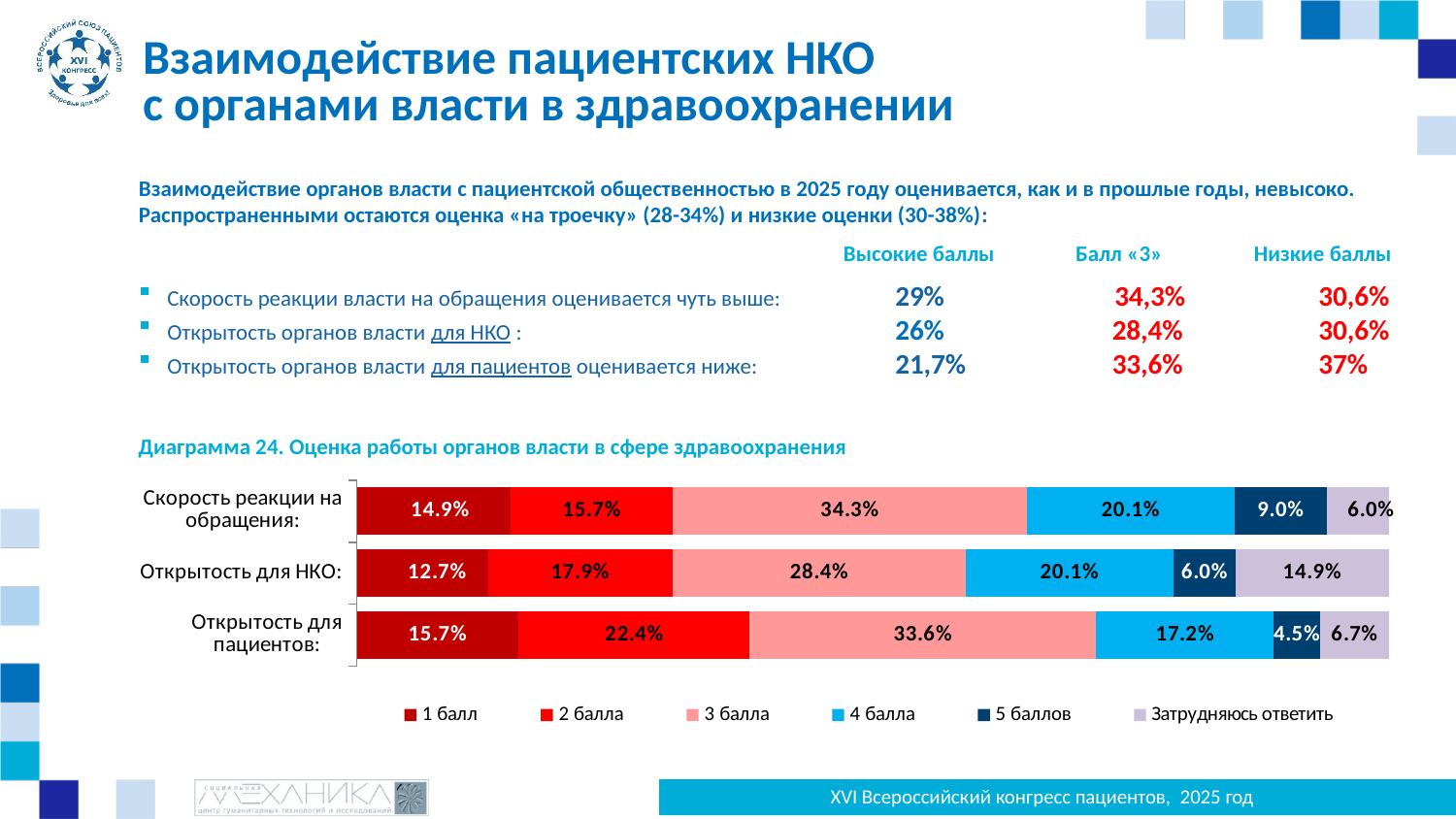
What is the value of the "2 балла" segment for "Открытость для пациентов"? 22.4% Which category has the highest "2 балла" value? Открытость для пациентов What is the value of the "3 балла" segment for "Скорость реакции на обращения" in the chart? 34.3% How many categories are shown in the chart? 3 What kind of chart is shown on the slide? Stacked bar chart Which category has the lowest "5 баллов" value? Открытость для пациентов How many series does the chart legend list? 6 What is the value of the "5 баллов" segment for "Скорость реакции на обращения"? 9.0% Which has the larger "4 балла" value: "Скорость реакции на обращения" or "Открытость для пациентов"? Скорость реакции на обращения What is the value of the "Затрудняюсь ответить" segment for "Открытость для НКО"? 14.9% What is the difference between the "3 балла" values for "Скорость реакции на обращения" and "Открытость для НКО"? 5.9% Which category has the highest "Затрудняюсь ответить" value? Открытость для НКО